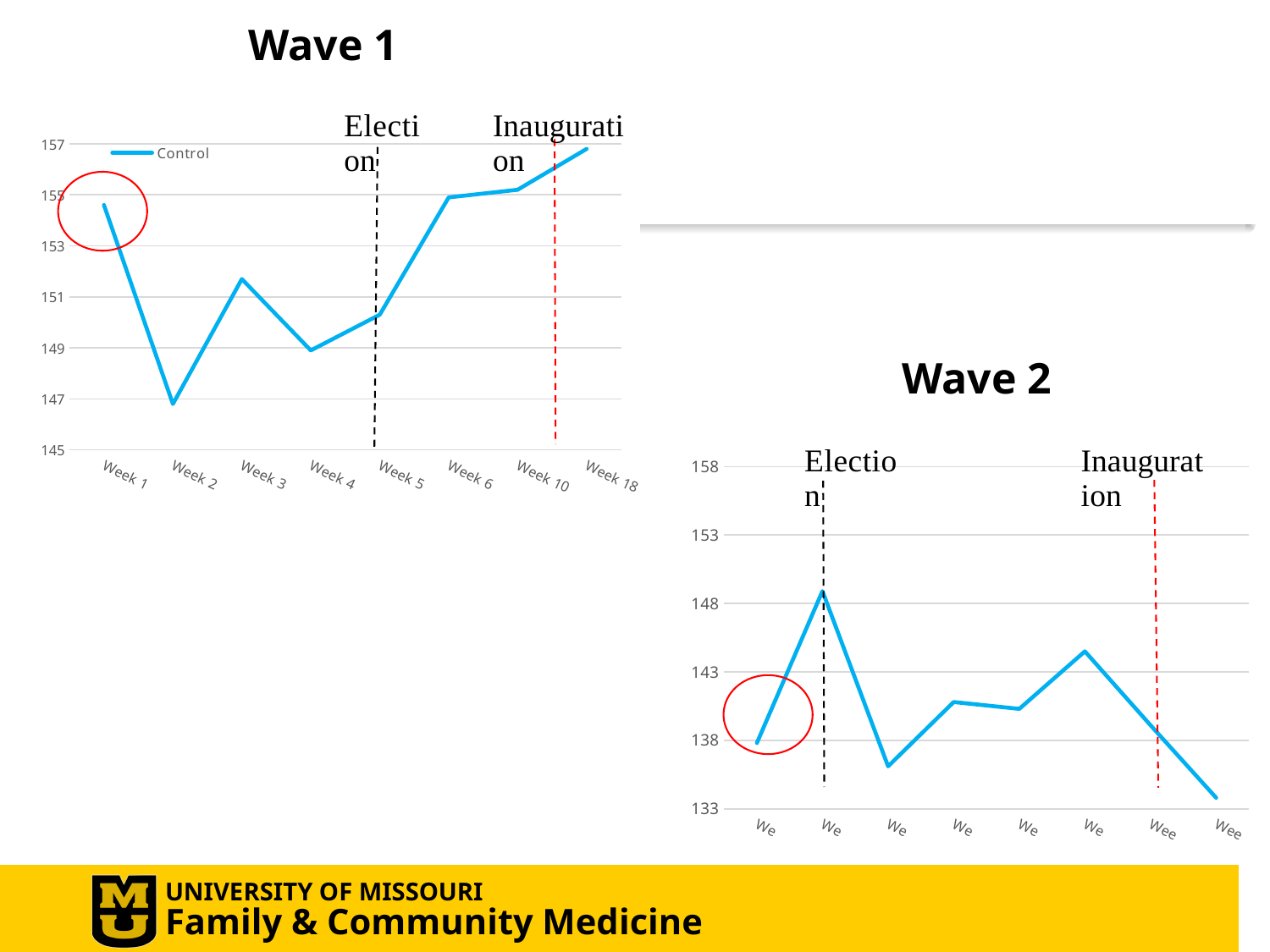
What series name is shown in the legend of the Wave 1 chart? Control On the Wave 1 chart, is the value for Week 2 greater or less than 149? less What kind of chart is the Wave 1 chart? line chart On the Wave 1 chart, which week has the lowest value? Week 2 How many series does the legend on the Wave 1 chart list? 1 On the Wave 1 chart, do the values rise or fall from Week 4 to Week 18? rise On the Wave 1 chart, is the value for Week 18 greater or less than 155? greater How many data points are plotted on the Wave 1 chart? 8 On the Wave 1 chart, is the value for Week 1 greater or less than 153? greater On the Wave 1 chart, which is larger, the value for Week 3 or the value for Week 4? Week 3 On the Wave 1 chart, which week has the highest value? Week 18